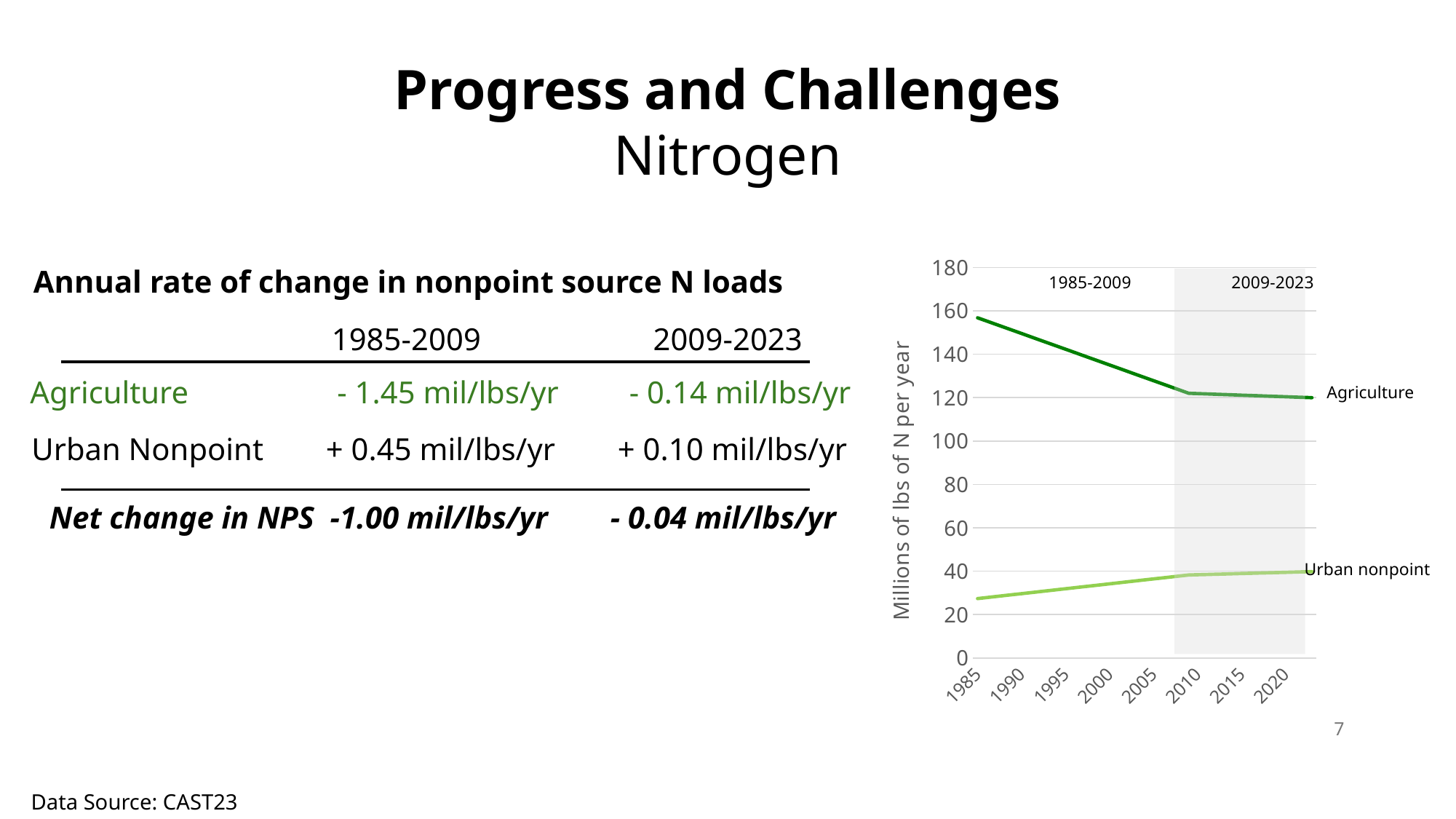
Is the Urban nonpoint value in 1985 greater or less than 40? less Which two series are labelled on the line chart? Agriculture and Urban nonpoint Is the Agriculture value in 2020 greater or less than 140? less What is the label of the y axis of the line chart? Millions of lbs of N per year Is the Urban nonpoint value in 2020 greater or less than 60? less In 2020, which series has the higher value, Agriculture or Urban nonpoint? Agriculture How many series are plotted in the line chart? 2 How many year labels are shown on the x axis of the line chart? 8 What kind of chart is shown on the right of the slide? line chart Does the Urban nonpoint line rise or fall from 1985 to 2020? rise Does the Agriculture line rise or fall from 1985 to 2020? fall